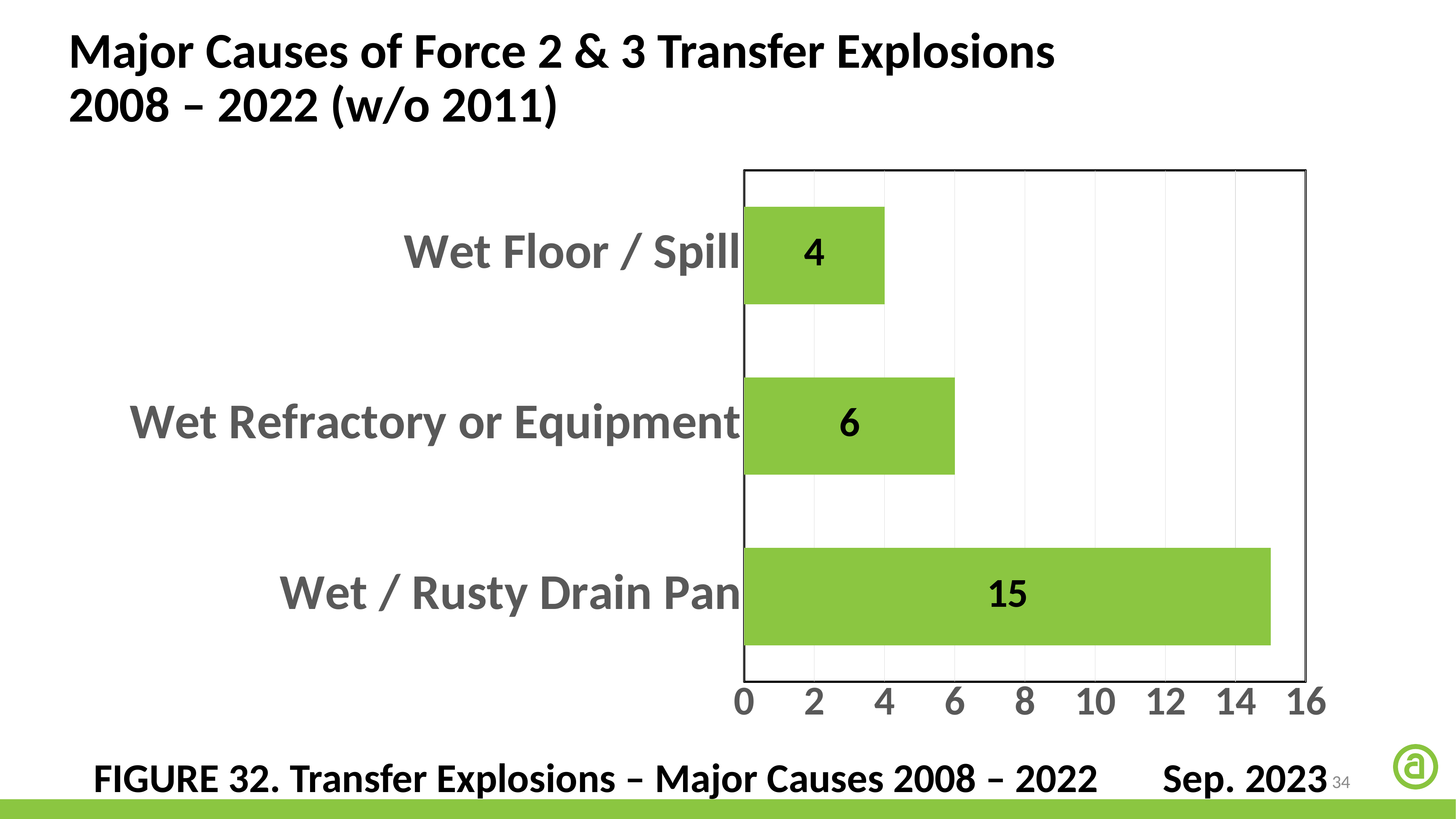
Is the value for Wet / Rusty Drain Pan greater or less than 10? greater Which cause has the lowest value? Wet Floor / Spill How many causes are shown in the chart? 3 Which cause has the highest value? Wet / Rusty Drain Pan What is the figure caption at the bottom of the slide? FIGURE 32. Transfer Explosions – Major Causes 2008 – 2022 What is the value for Wet Refractory or Equipment? 6 What kind of chart is shown on the slide? bar chart What is the difference between the values for Wet / Rusty Drain Pan and Wet Refractory or Equipment? 9 What is the difference between the values for Wet Refractory or Equipment and Wet Floor / Spill? 2 What is the value for Wet / Rusty Drain Pan? 15 What is the value for Wet Floor / Spill? 4 Which is larger, the value for Wet Refractory or Equipment or the value for Wet Floor / Spill? Wet Refractory or Equipment